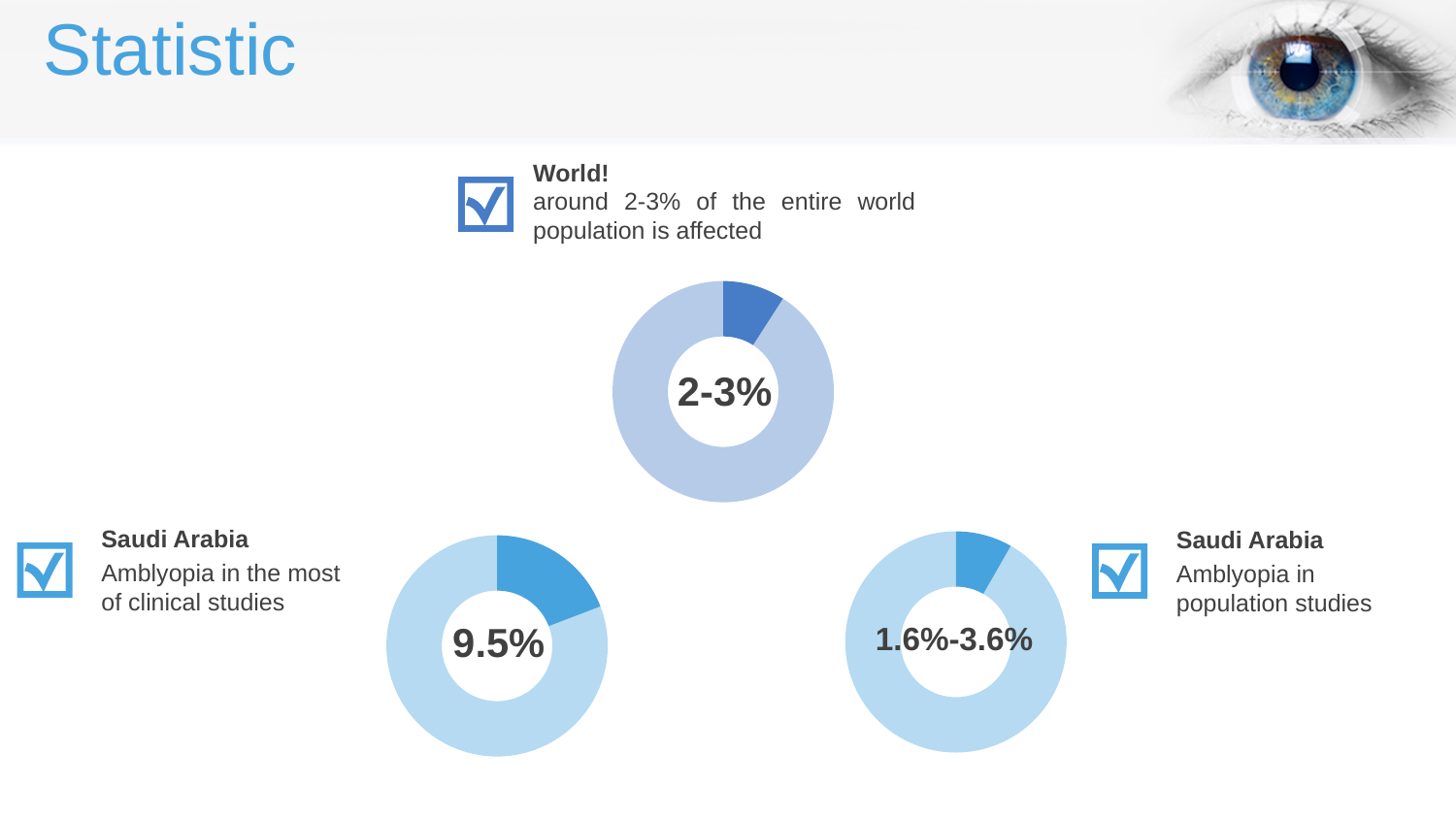
What is the title of the slide containing the donut charts? Statistic What kind of chart is used to show the amblyopia statistics on this slide? Donut (pie) chart How many donut charts are shown on the slide? 3 Is the value shown in the bottom-left donut chart (Saudi Arabia clinical studies) greater or less than 5%? greater Which chart shows the larger highlighted share: the Saudi Arabia clinical studies chart (9.5%) or the world chart (2-3%)? Saudi Arabia clinical studies (9.5%) What value is shown in the centre of the bottom-right donut chart for Saudi Arabia population studies? 1.6%-3.6% Which country do the two bottom donut charts refer to? Saudi Arabia Which of the three donut charts has the largest highlighted slice? The Saudi Arabia clinical studies chart (9.5%) What value is shown in the centre of the bottom-left donut chart for Saudi Arabia clinical studies? 9.5% What value is shown in the centre of the top donut chart for the world population? 2-3%